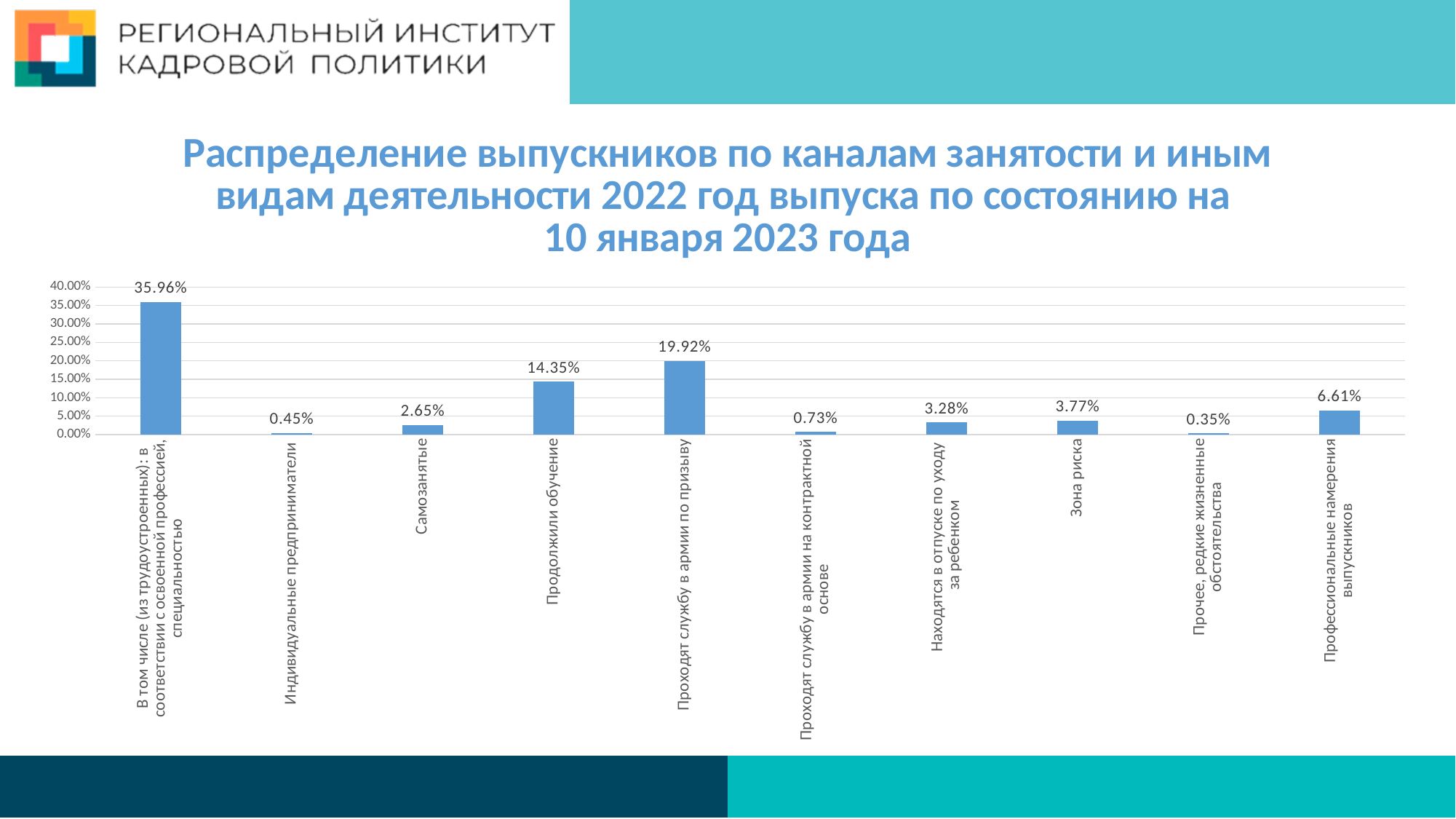
Is the value for «Проходят службу в армии по призыву» greater or less than 15.00%? greater What is the value for «Самозанятые»? 2.65% What is the difference between «Профессиональные намерения выпускников» and «Зона риска»? 2.84% What is the difference between «Проходят службу в армии по призыву» and «Продолжили обучение»? 5.57% How many categories are plotted in the chart? 10 What is the value for «Продолжили обучение»? 14.35% Which category has the highest value? В том числе (из трудоустроенных): в соответствии с освоенной профессией, специальностью Which category has the lowest value? Прочее, редкие жизненные обстоятельства What kind of chart is shown on the slide? Bar chart Which is larger: «Зона риска» or «Находятся в отпуске по уходу за ребенком»? Зона риска What is the value for «Проходят службу в армии по призыву»? 19.92% What is the value for «Профессиональные намерения выпускников»? 6.61%